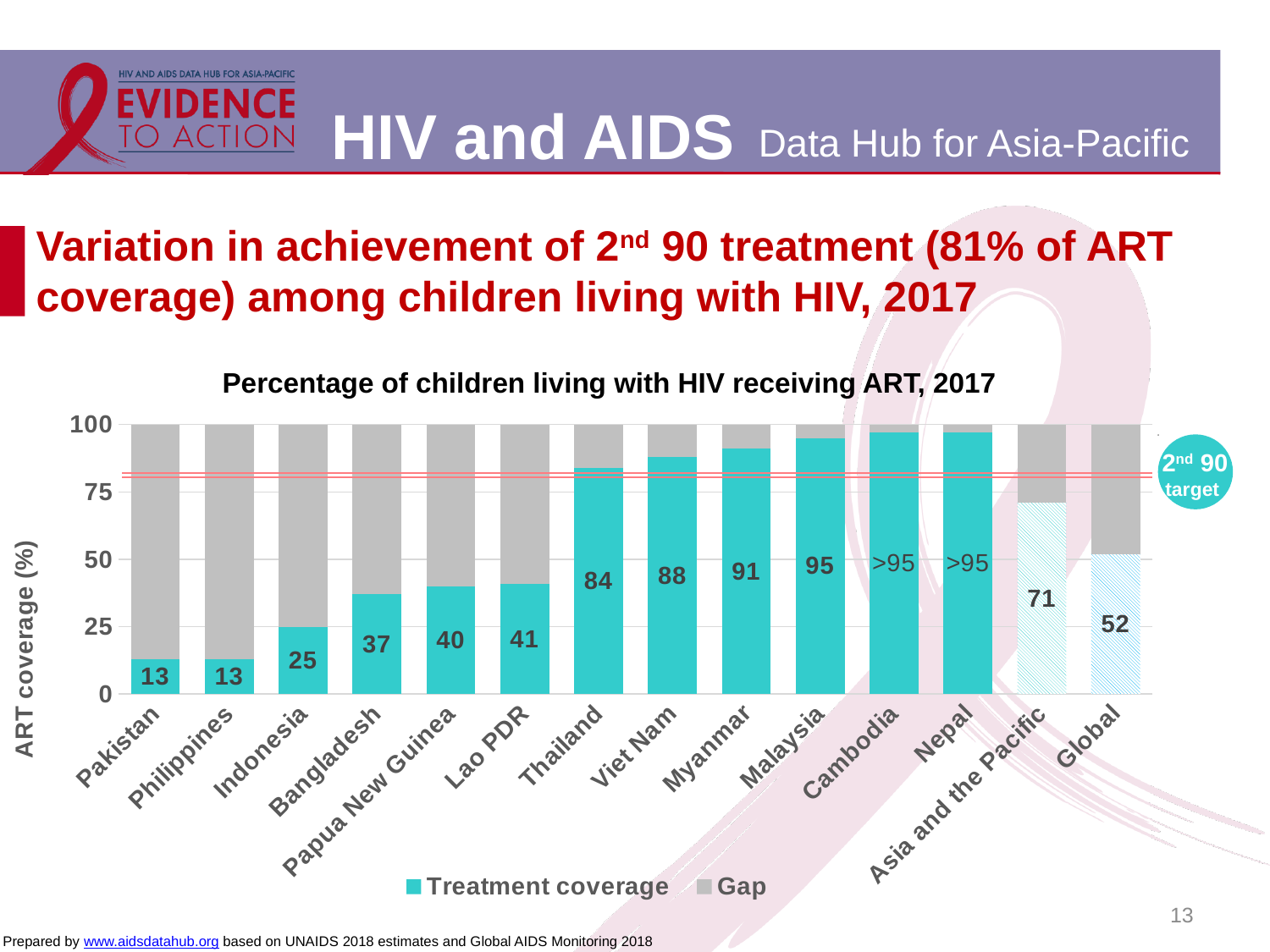
Which has higher treatment coverage, Myanmar or Viet Nam? Myanmar What kind of chart is shown on the slide? Stacked bar chart How many categories are shown on the x axis? 14 What is the treatment coverage value for Indonesia? 25 What is the difference in treatment coverage between Asia and the Pacific and Global? 19 Is the treatment coverage value for Bangladesh greater or less than 25? greater What is the treatment coverage value for Asia and the Pacific? 71 Do the treatment coverage values for the countries rise or fall from Pakistan to Nepal along the x axis? Rise What is the difference in treatment coverage between Thailand and Lao PDR? 43 What is the treatment coverage value for Thailand? 84 What is the treatment coverage value shown for Cambodia? >95 How many series does the legend list? 2